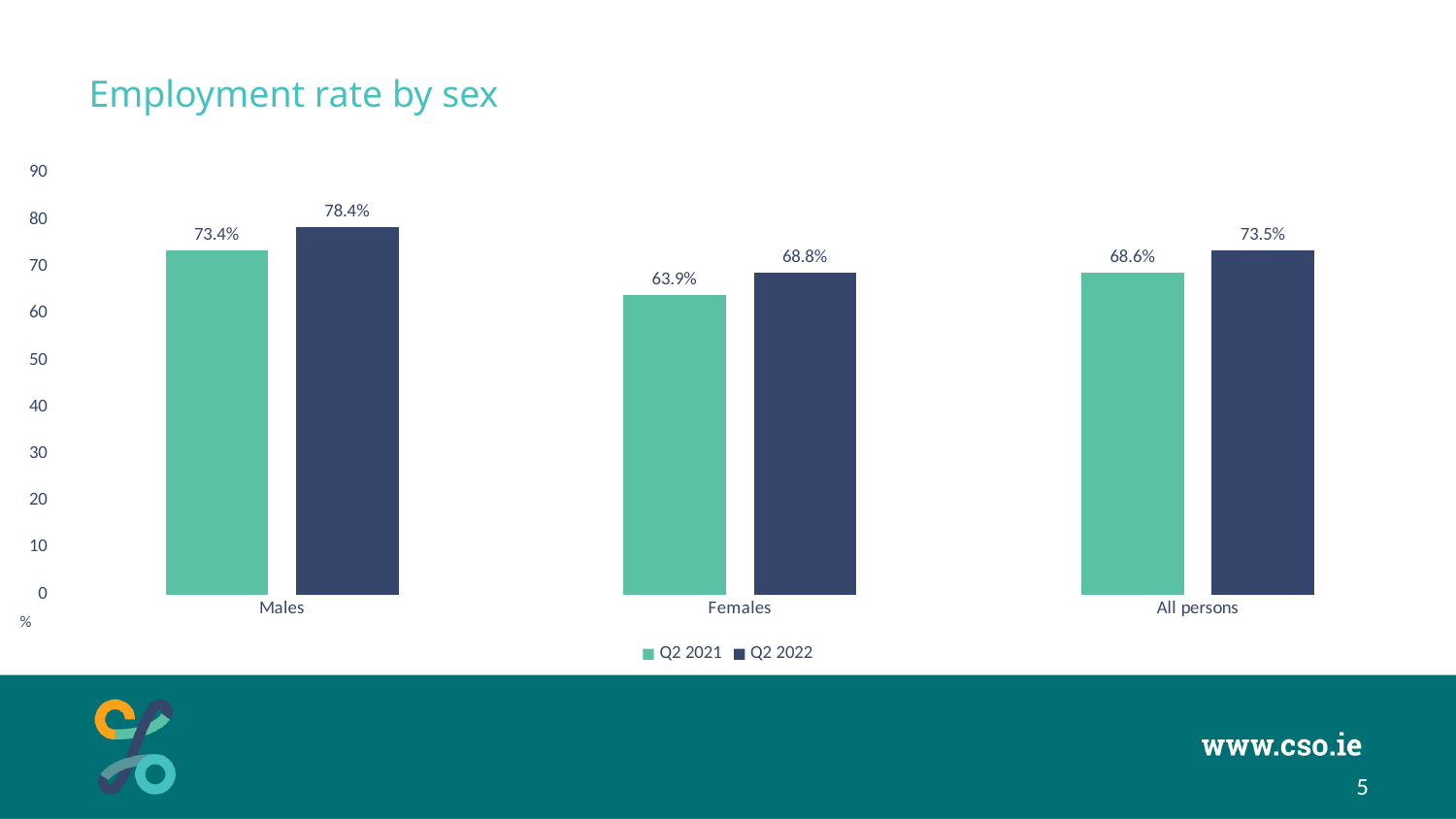
Which is larger: the Q2 2021 employment rate for Males or the Q2 2022 employment rate for All persons? Q2 2022 employment rate for All persons What kind of chart is shown on the slide? Bar chart Which category has the highest employment rate in Q2 2022? Males How many series does the legend list? 2 What is the employment rate for Females in Q2 2021? 63.9% What is the difference between the Q2 2022 and Q2 2021 employment rates for Females? 4.9% What is the employment rate for All persons in Q2 2022? 73.5% How many categories are shown on the x axis? 3 What is the employment rate for Males in Q2 2022? 78.4% Which category has the lowest employment rate in Q2 2021? Females What is the difference between the Q2 2022 and Q2 2021 employment rates for Males? 5.0% Is the Q2 2021 employment rate for Females greater or less than 70? less